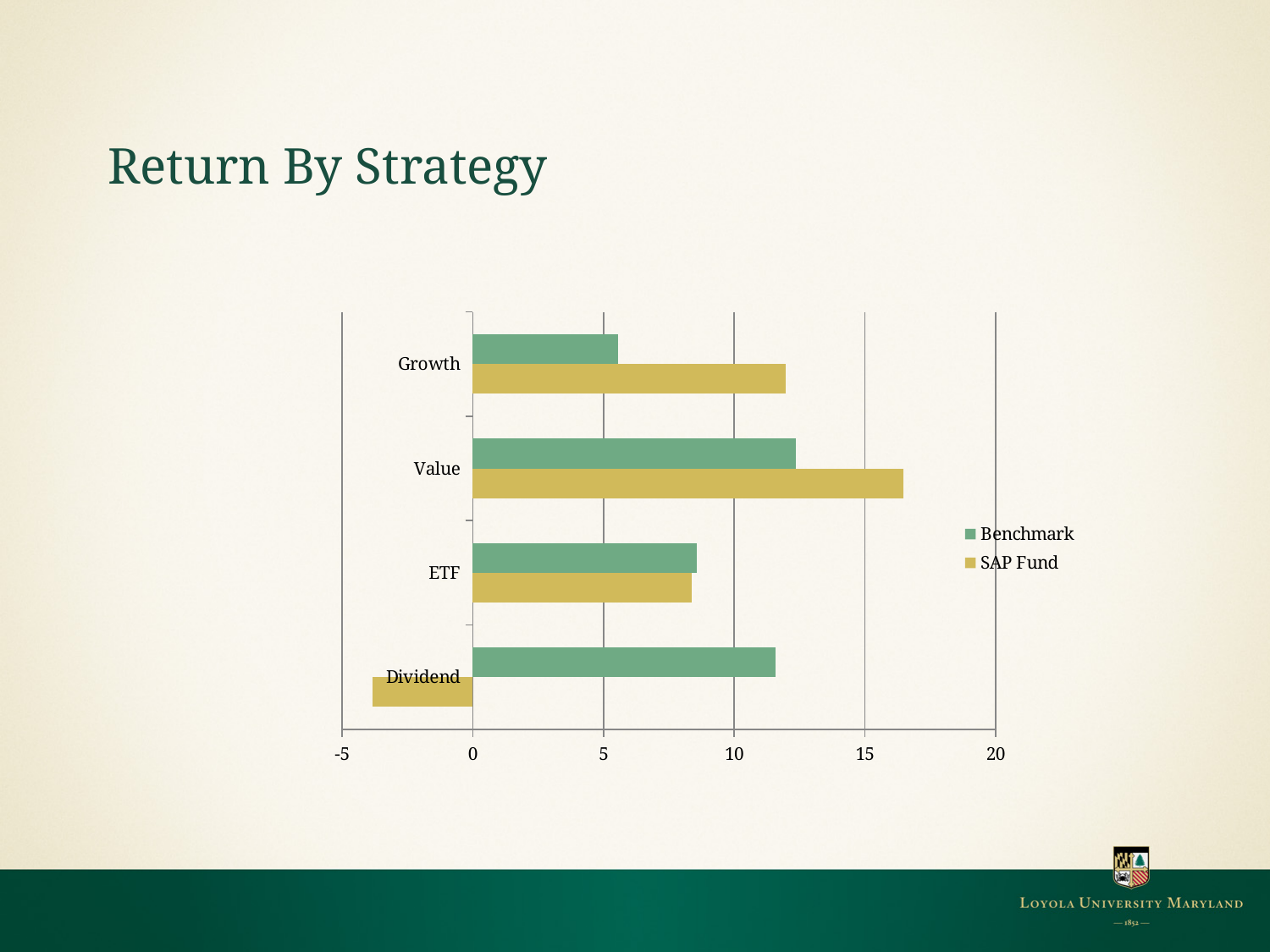
Is the SAP Fund value for Dividend greater or less than 0? less Which strategy has the lowest SAP Fund return? Dividend What is the title of the chart? Return By Strategy For Growth, which is larger: the Benchmark return or the SAP Fund return? SAP Fund Which strategy has the highest SAP Fund return? Value What kind of chart is shown on the slide? bar chart For Dividend, which is larger: the Benchmark return or the SAP Fund return? Benchmark Which strategy has the highest Benchmark return? Value How many series does the legend list? 2 How many strategy categories are shown on the chart? 4 Which strategy has the lowest Benchmark return? Growth Is the SAP Fund value for Value greater or less than 15? greater